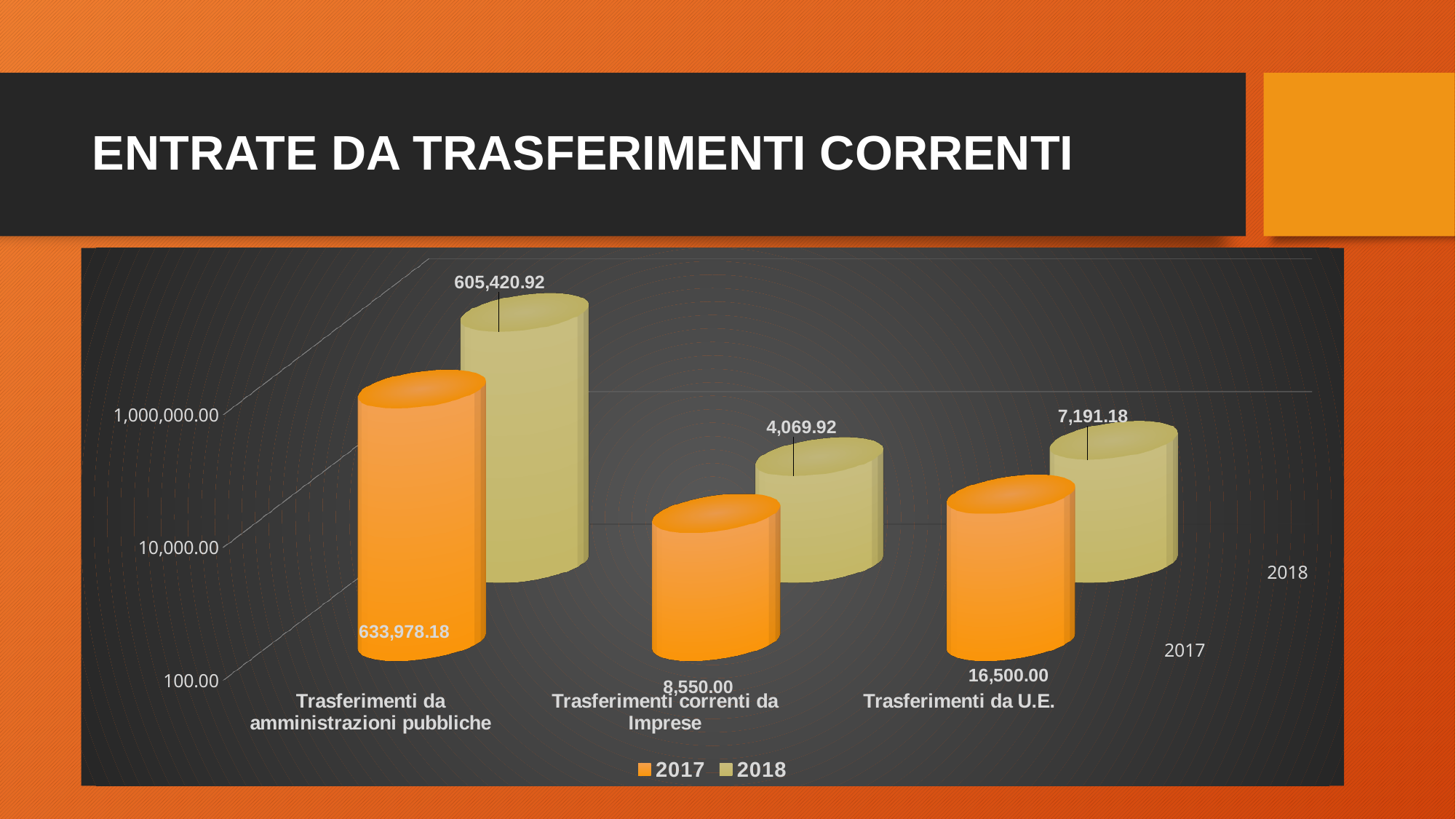
What is the difference between the 2017 and 2018 values for Trasferimenti da U.E.? 9,308.82 What is the 2018 value for Trasferimenti da amministrazioni pubbliche? 605,420.92 What kind of chart is shown on the slide? Bar chart How many categories are shown on the x axis? 3 Which category has the lowest 2018 value? Trasferimenti correnti da Imprese Which category has the highest 2017 value? Trasferimenti da amministrazioni pubbliche For Trasferimenti da amministrazioni pubbliche, which year has the larger value, 2017 or 2018? 2017 What is the 2018 value for Trasferimenti correnti da Imprese? 4,069.92 How many series does the legend list? 2 What is the difference between the 2017 and 2018 values for Trasferimenti correnti da Imprese? 4,480.08 What is the 2017 value for Trasferimenti da U.E.? 16,500.00 What is the 2017 value for Trasferimenti da amministrazioni pubbliche? 633,978.18